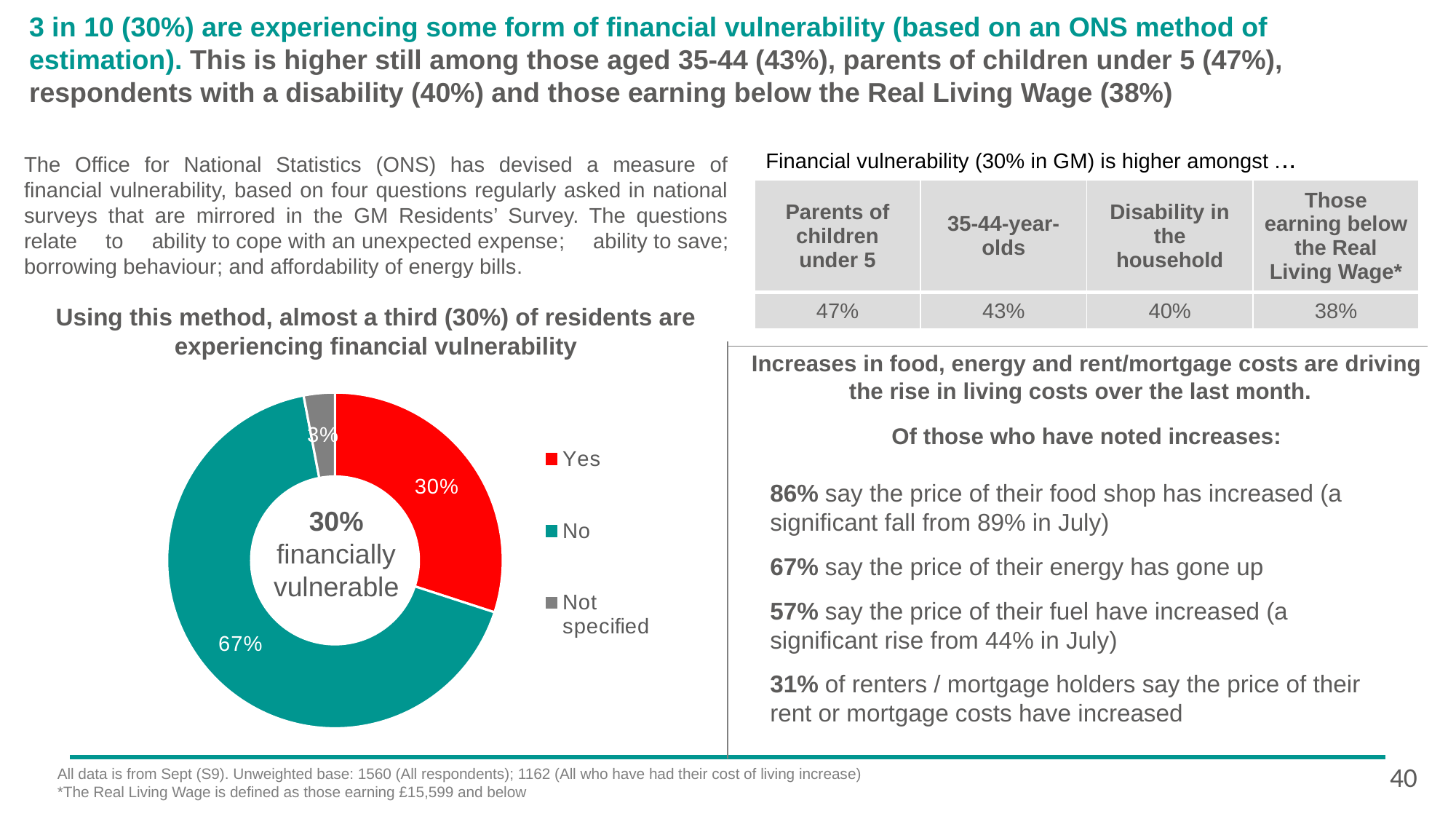
What percentage is shown for "Not specified" in the pie chart? 3% How many entries does the pie chart's legend list? 3 Which slice is larger in the pie chart, "Yes" or "Not specified"? Yes Which category has the smallest slice in the pie chart? Not specified What percentage of residents answered "Yes" in the pie chart? 30% What colour is the "Yes" slice in the pie chart? Red What percentage of residents answered "No" in the pie chart? 67% What kind of chart is shown on the slide? Pie chart (donut) What text is shown in the centre of the donut chart? 30% financially vulnerable Which category has the largest slice in the pie chart? No What is the difference in percentage points between the "No" and "Yes" slices? 37 How many categories does the pie chart show? 3